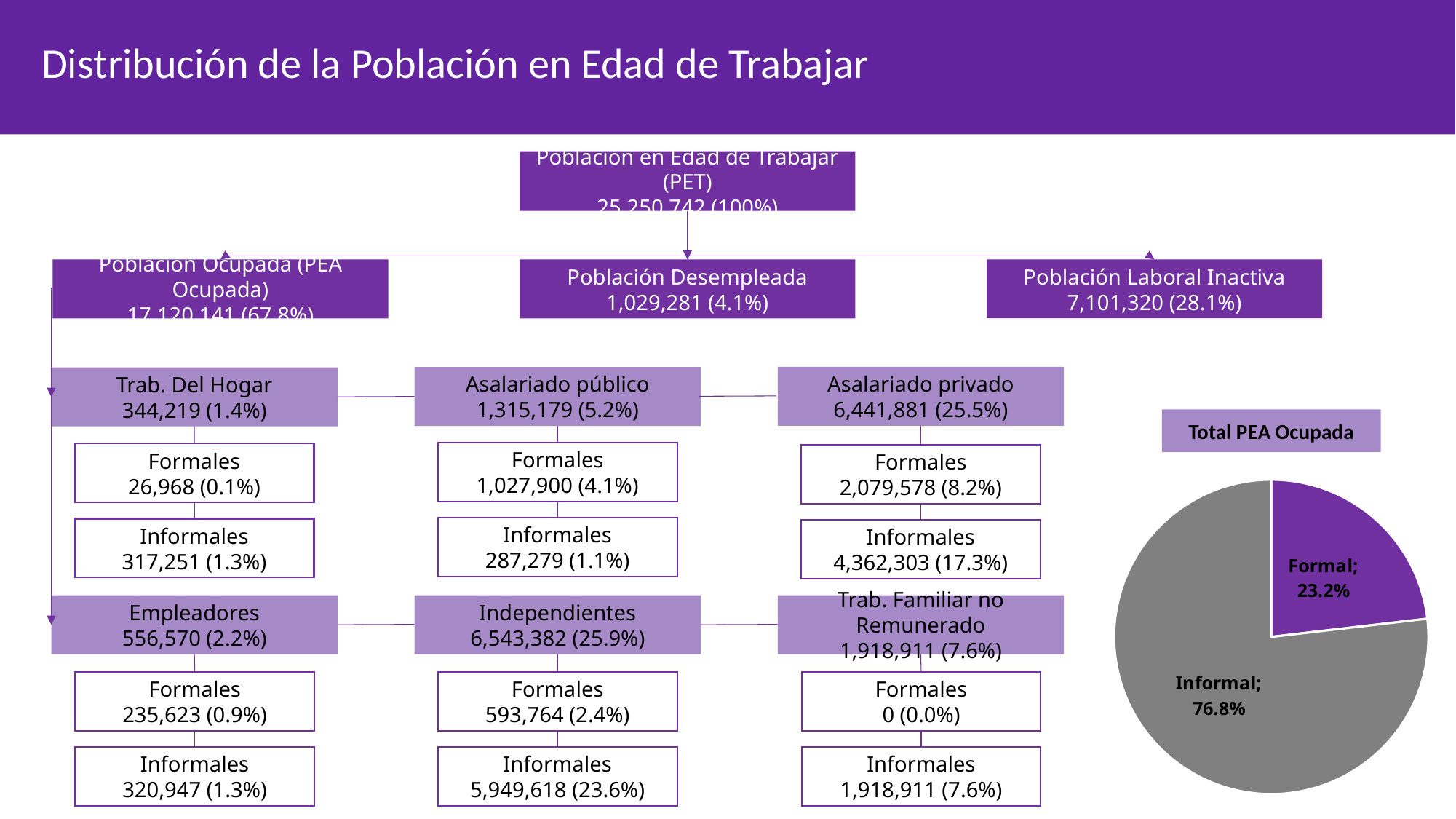
In the "Total PEA Ocupada" pie chart, is the Formal share greater or less than 25%? less In the "Total PEA Ocupada" pie chart, what is the difference in percentage points between the Informal and Formal shares? 53.6 What is the title of the pie chart on the slide? Total PEA Ocupada In the "Total PEA Ocupada" pie chart, which slice is the smallest? Formal In the "Total PEA Ocupada" pie chart, is the Informal share greater or less than 75%? greater In the "Total PEA Ocupada" pie chart, which slice is the largest? Informal In the "Total PEA Ocupada" pie chart, which is larger, the Formal slice or the Informal slice? Informal What kind of chart is the "Total PEA Ocupada" chart on the right of the slide? pie chart In the "Total PEA Ocupada" pie chart, how many slices are there? 2 In the "Total PEA Ocupada" pie chart, what share is labelled Formal? 23.2% In the "Total PEA Ocupada" pie chart, what share is labelled Informal? 76.8% In the "Total PEA Ocupada" pie chart, what colour is the Informal slice? grey